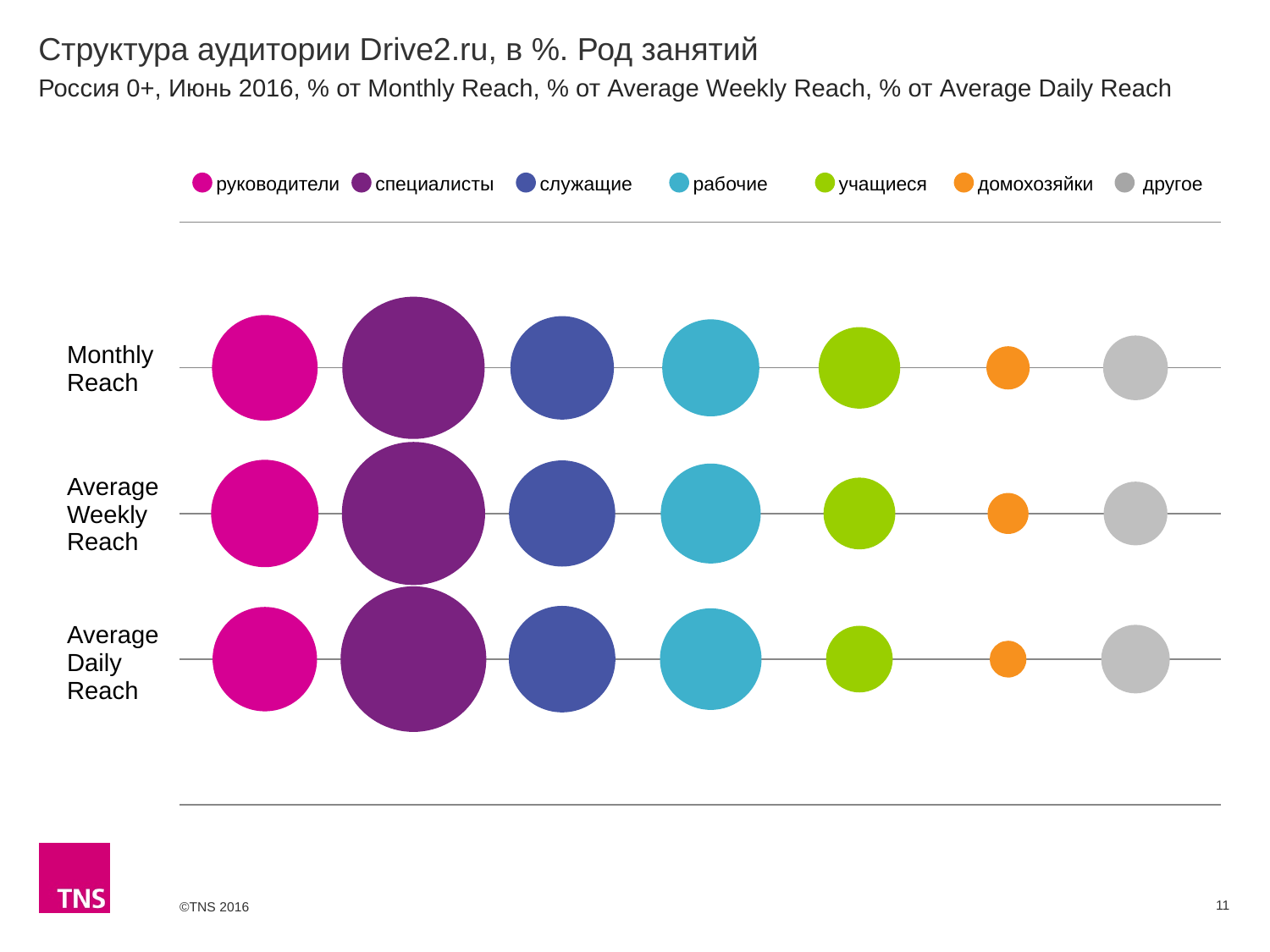
How many reach categories (rows) are plotted on the chart? 3 In the Monthly Reach row, which bubble is larger: руководители or учащиеся? руководители In the Average Weekly Reach row, which bubble is larger: специалисты or служащие? специалисты Which occupation group has the largest bubble in the Average Daily Reach row? специалисты In the Average Daily Reach row, which bubble is larger: другое or домохозяйки? другое Which occupation group has the smallest bubble in the Monthly Reach row? домохозяйки Which occupation group has the smallest bubble in the Average Weekly Reach row? домохозяйки Which legend entry is shown in orange? домохозяйки Which occupation group has the largest bubble in the Monthly Reach row? специалисты What kind of chart is shown on the slide? Bubble chart What is the title of the chart on the slide? Структура аудитории Drive2.ru, в %. Род занятий How many series does the legend list? 7